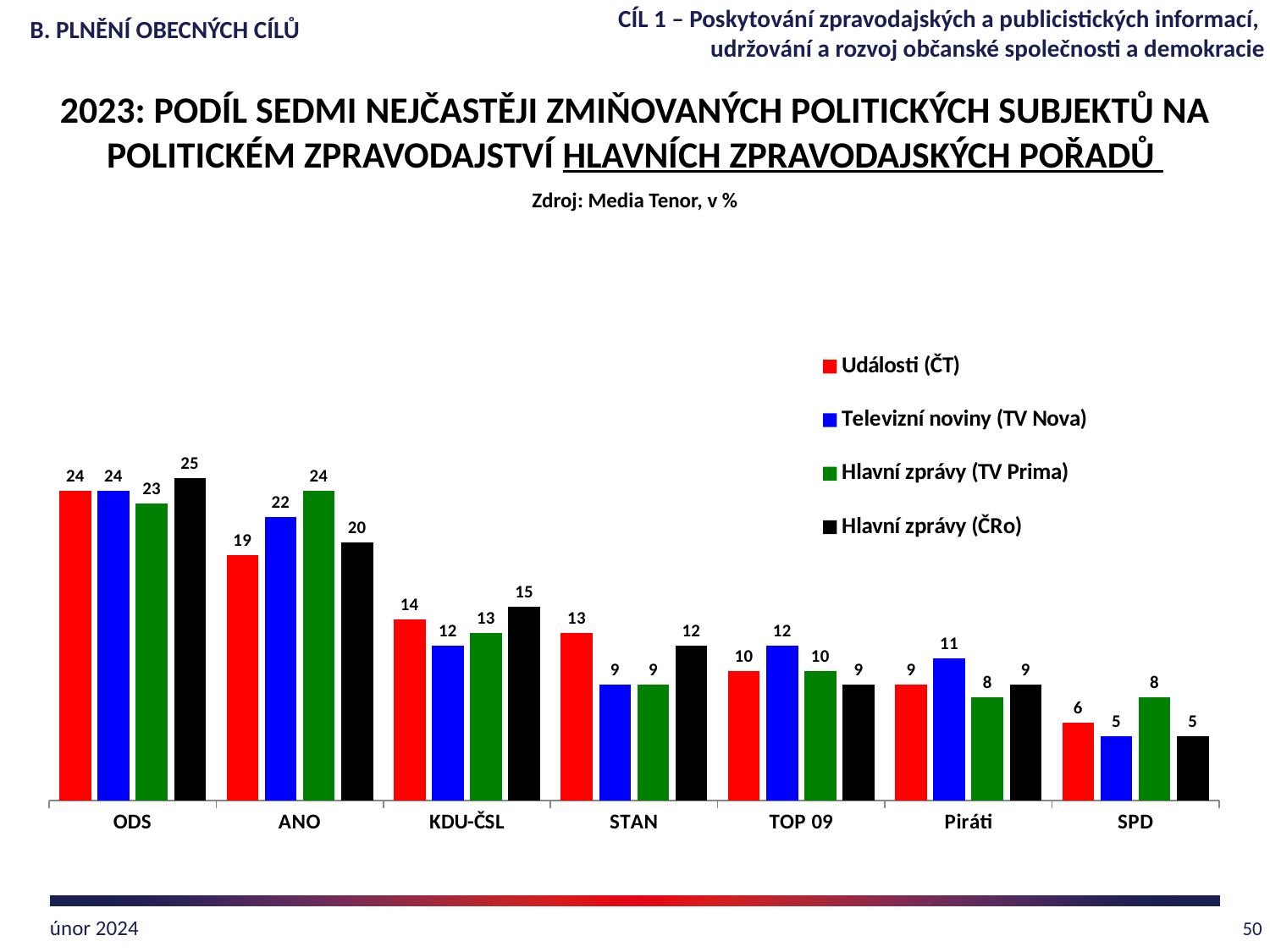
What is the difference between the Hlavní zprávy (ČRo) value for ODS and the Hlavní zprávy (ČRo) value for ANO? 5 What is the value for SPD in the Televizní noviny (TV Nova) series? 5 How many political parties are shown on the x axis? 7 What colour represents the Hlavní zprávy (ČRo) series? Black How many series does the legend list? 4 What is the value for ODS in the Hlavní zprávy (ČRo) series? 25 What is the value for ANO in the Hlavní zprávy (TV Prima) series? 24 Which is larger for KDU-ČSL: the Události (ČT) value or the Televizní noviny (TV Nova) value? Události (ČT) What kind of chart is shown on the slide? Bar chart What is the value for STAN in the Události (ČT) series? 13 Which political party has the highest value in the Události (ČT) series? ODS Which political party has the lowest value in the Hlavní zprávy (TV Prima) series? SPD